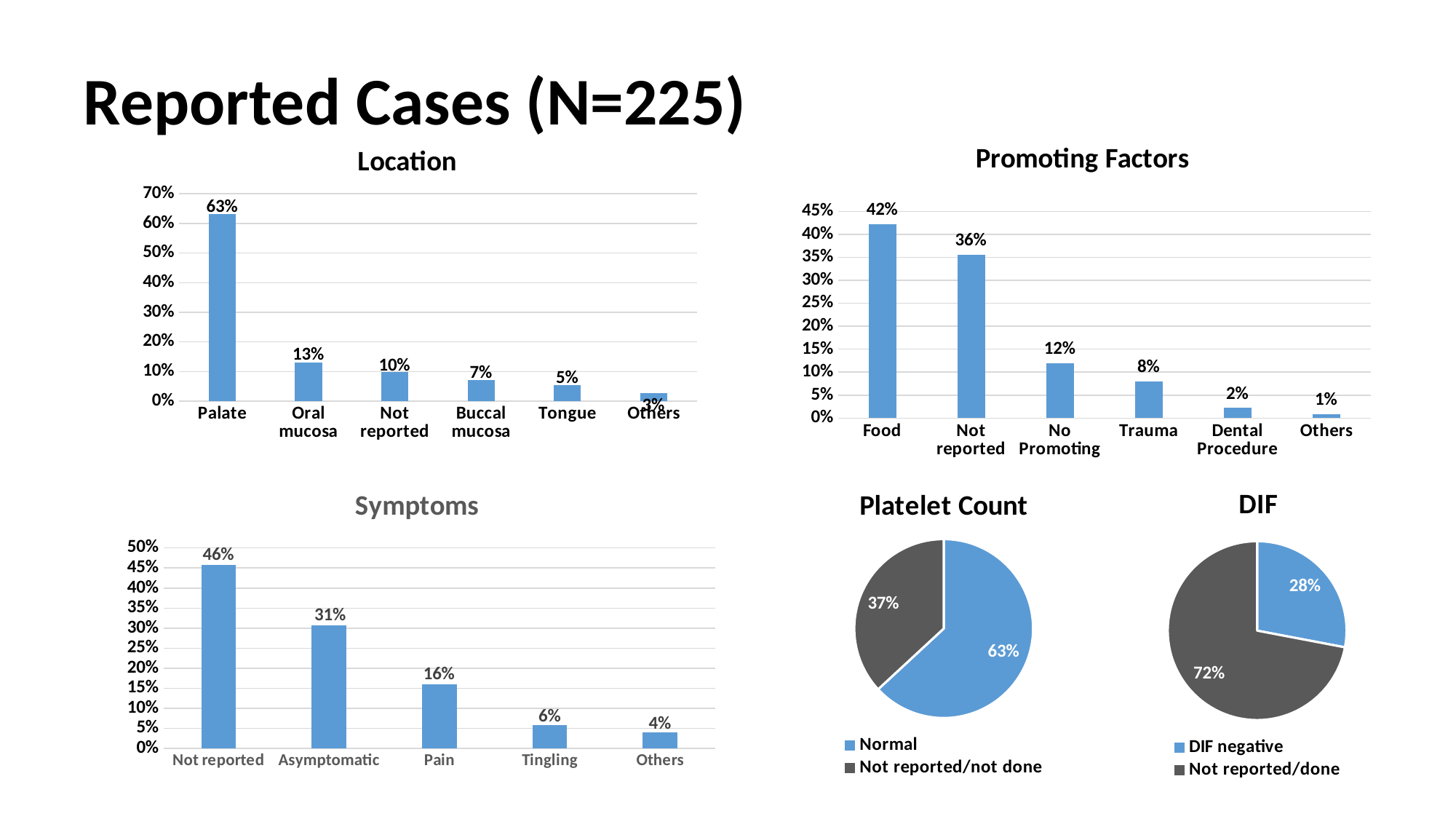
In the Promoting Factors chart, how many categories are shown? 6 In the Symptoms chart, what is the difference between Not reported and Asymptomatic? 15% In the Promoting Factors chart, what is the value for Trauma? 8% In the Location chart, what is the difference between Oral mucosa and Tongue? 8% In the Location chart, which category has the lowest value? Others In the Symptoms chart, which is larger, Asymptomatic or Tingling? Asymptomatic In the Symptoms chart, what is the value for Pain? 16% In the Location chart, what is the value for Palate? 63% What kind of chart is the Symptoms chart? Bar chart In the DIF pie chart, what share is DIF negative? 28% In the Promoting Factors chart, which category has the highest value? Food In the Platelet Count pie chart, what share is Normal? 63%